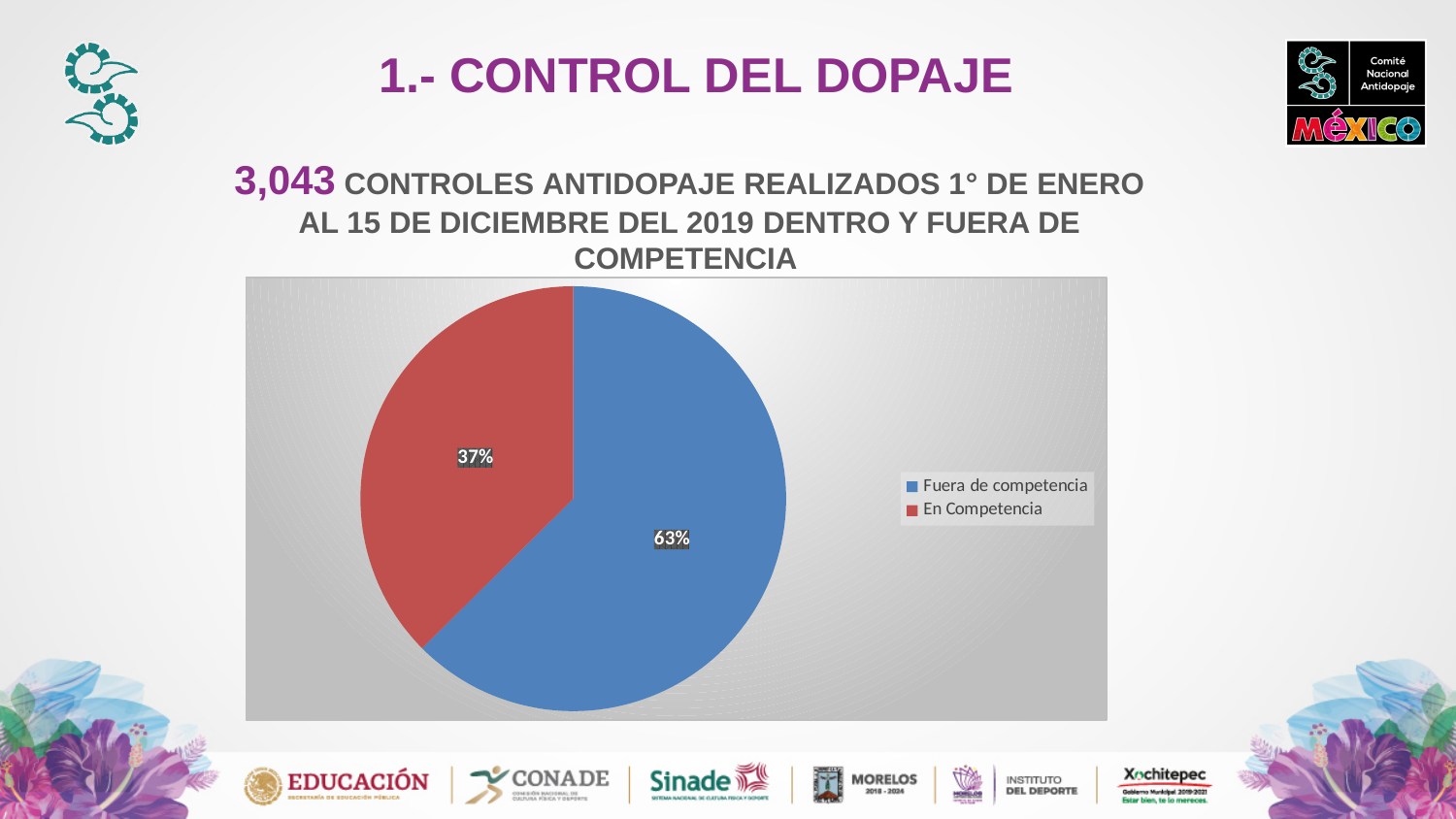
Which category has the smallest share of the pie? En Competencia What percentage of the pie is labelled for Fuera de competencia? 63% How many entries does the legend list? 2 What colour is the slice for En Competencia? red What kind of chart is shown on the slide? pie chart How many slices does the pie chart have? 2 What percentage of the pie is labelled for En Competencia? 37% Which is larger, the share for Fuera de competencia or the share for En Competencia? Fuera de competencia What is the share of the pie taken by the Fuera de competencia slice? 63% What is the difference in percentage points between Fuera de competencia and En Competencia? 26 What colour is the slice for Fuera de competencia? blue Which category has the largest share of the pie? Fuera de competencia